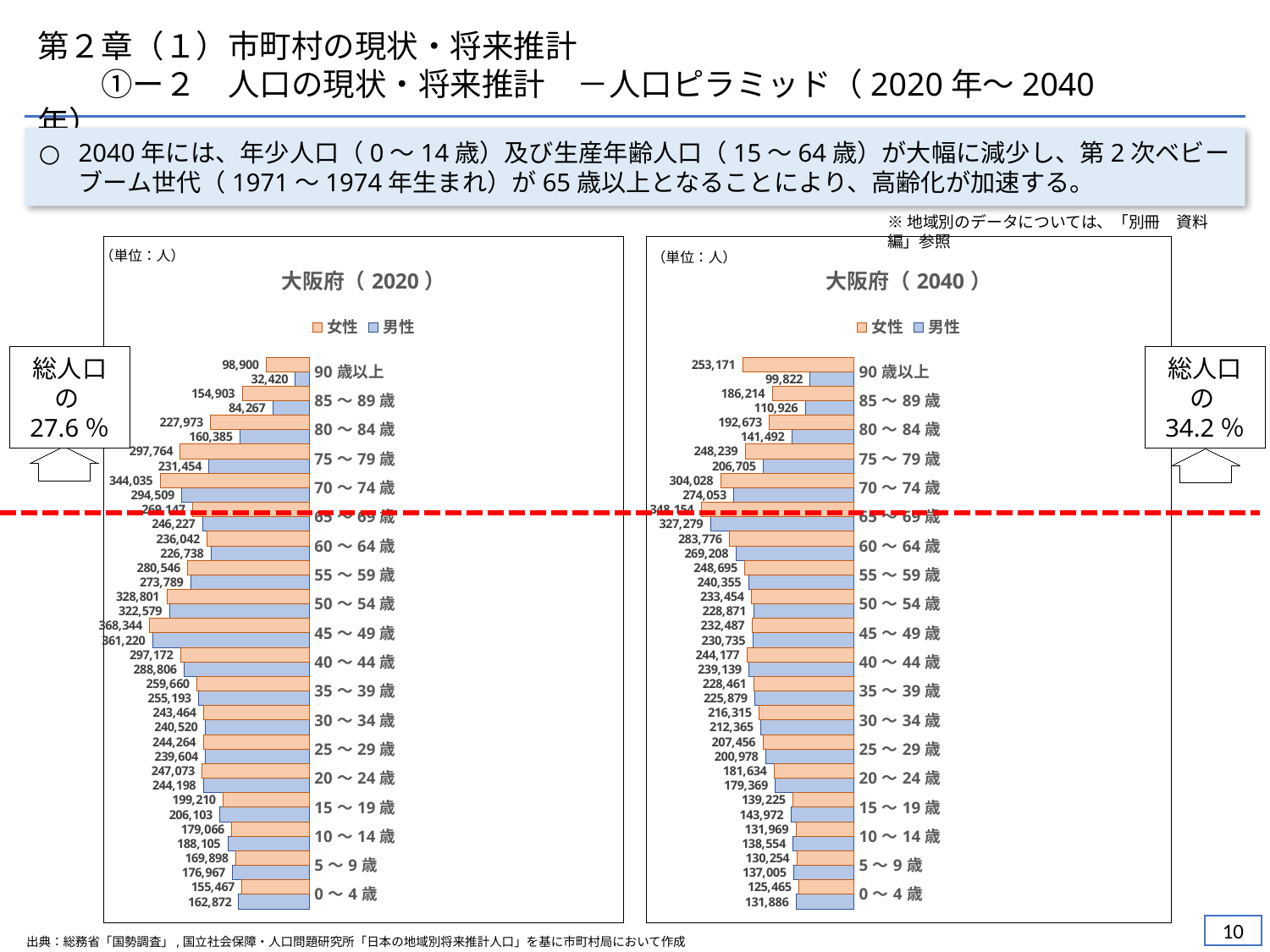
In the 大阪府（2040） chart, what is the 男性 value for the 0～4歳 age group? 131,886 In the 大阪府（2020） chart, which age group has the highest 女性 value? 45～49歳 In the 大阪府（2020） chart, what is the difference between the 女性 and 男性 values for the 90歳以上 age group? 66,480 In the 大阪府（2040） chart, which age group has the lowest 女性 value? 0～4歳 How many age groups are shown in the 大阪府（2040） chart? 19 In the 大阪府（2020） chart, what is the 女性 value for the 90歳以上 age group? 98,900 In the 大阪府（2040） chart, what is the 女性 value for the 70～74歳 age group? 304,028 In the 大阪府（2020） chart, which age group has the lowest 男性 value? 90歳以上 What type of chart is the 大阪府（2020） chart? Bar chart In the 大阪府（2040） chart, which is larger for the 15～19歳 age group, the 女性 value or the 男性 value? 男性 In the 大阪府（2020） chart, what is the 男性 value for the 45～49歳 age group? 361,220 How many series does the legend of the 大阪府（2020） chart list? 2